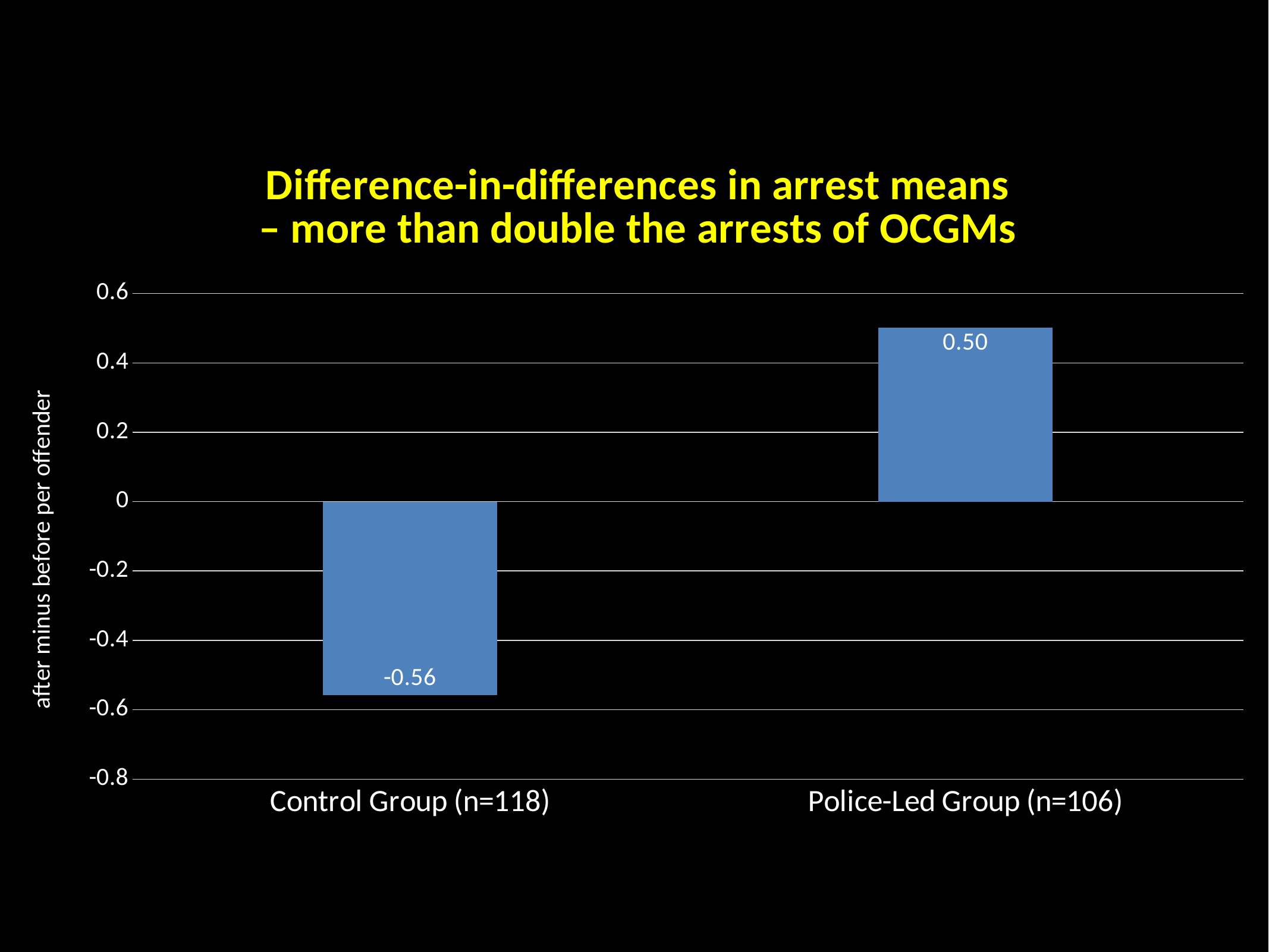
Which group has the lowest value? Control Group (n=118) What is the difference between the Police-Led Group value and the Control Group value? 1.06 Is the value for the Police-Led Group (n=106) greater or less than 0.4? greater What is the label of the vertical axis? after minus before per offender What is the title of the chart? Difference-in-differences in arrest means – more than double the arrests of OCGMs Which group has the highest value? Police-Led Group (n=106) Is the value for the Control Group (n=118) greater or less than -0.4? less What kind of chart is shown on the slide? bar chart What is the value for the Control Group (n=118)? -0.56 How many groups are shown on the chart? 2 What is the value for the Police-Led Group (n=106)? 0.50 Which is larger, the value for the Control Group or the value for the Police-Led Group? Police-Led Group